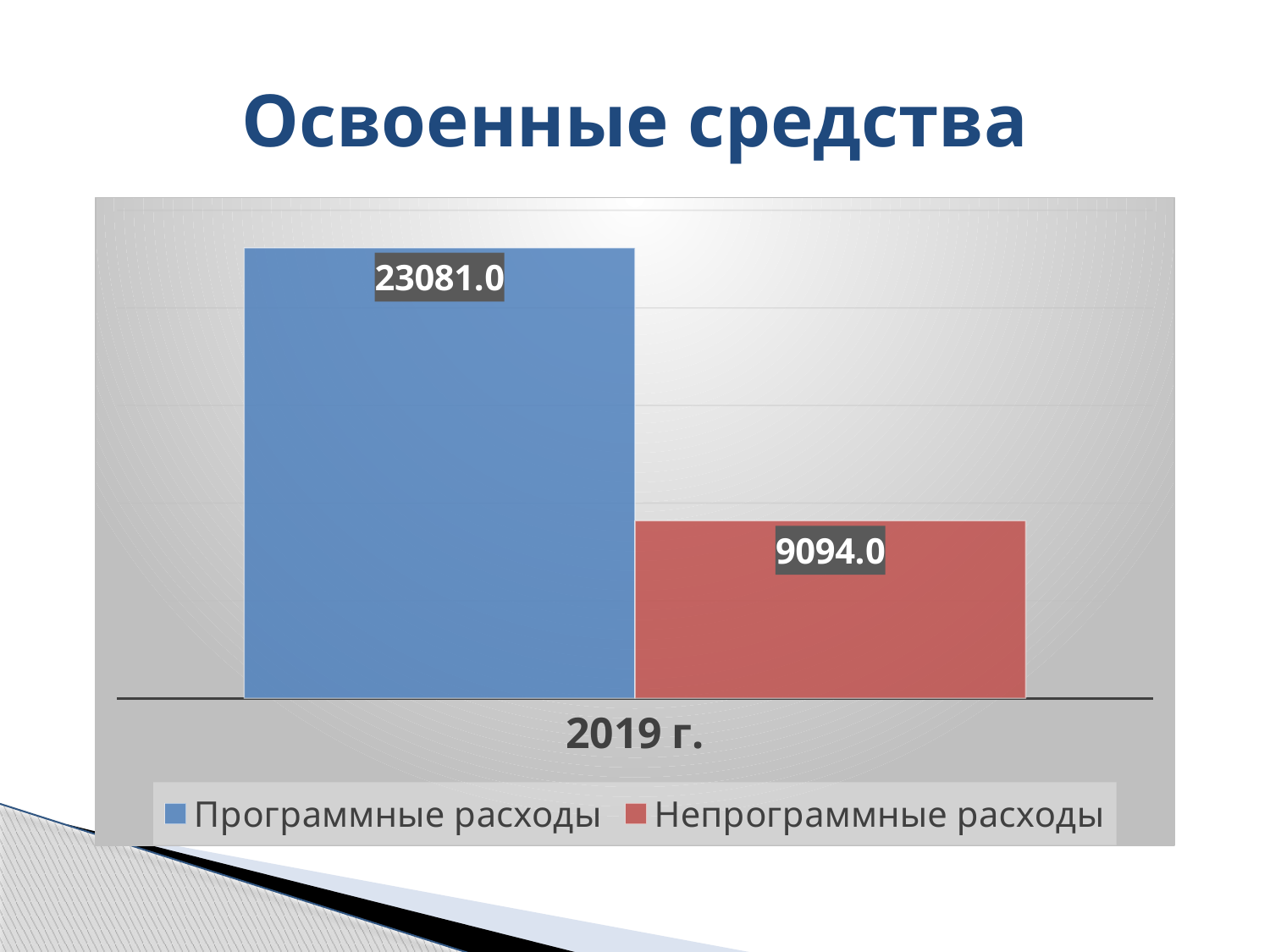
What kind of chart is shown on the slide? bar chart How many series does the legend list? 2 Is the value for Программные расходы larger or smaller than the value for Непрограммные расходы? larger How many categories are shown on the x axis? 1 What is the value for Непрограммные расходы in 2019 г.? 9094.0 What is the difference between Программные расходы and Непрограммные расходы in 2019 г.? 13987.0 What is the total of Программные расходы and Непрограммные расходы in 2019 г.? 32175.0 What colour is the bar for Непрограммные расходы? red Which series has the lower value in 2019 г.? Непрограммные расходы What is the title of the slide? Освоенные средства What is the value for Программные расходы in 2019 г.? 23081.0 Which series has the higher value in 2019 г.? Программные расходы